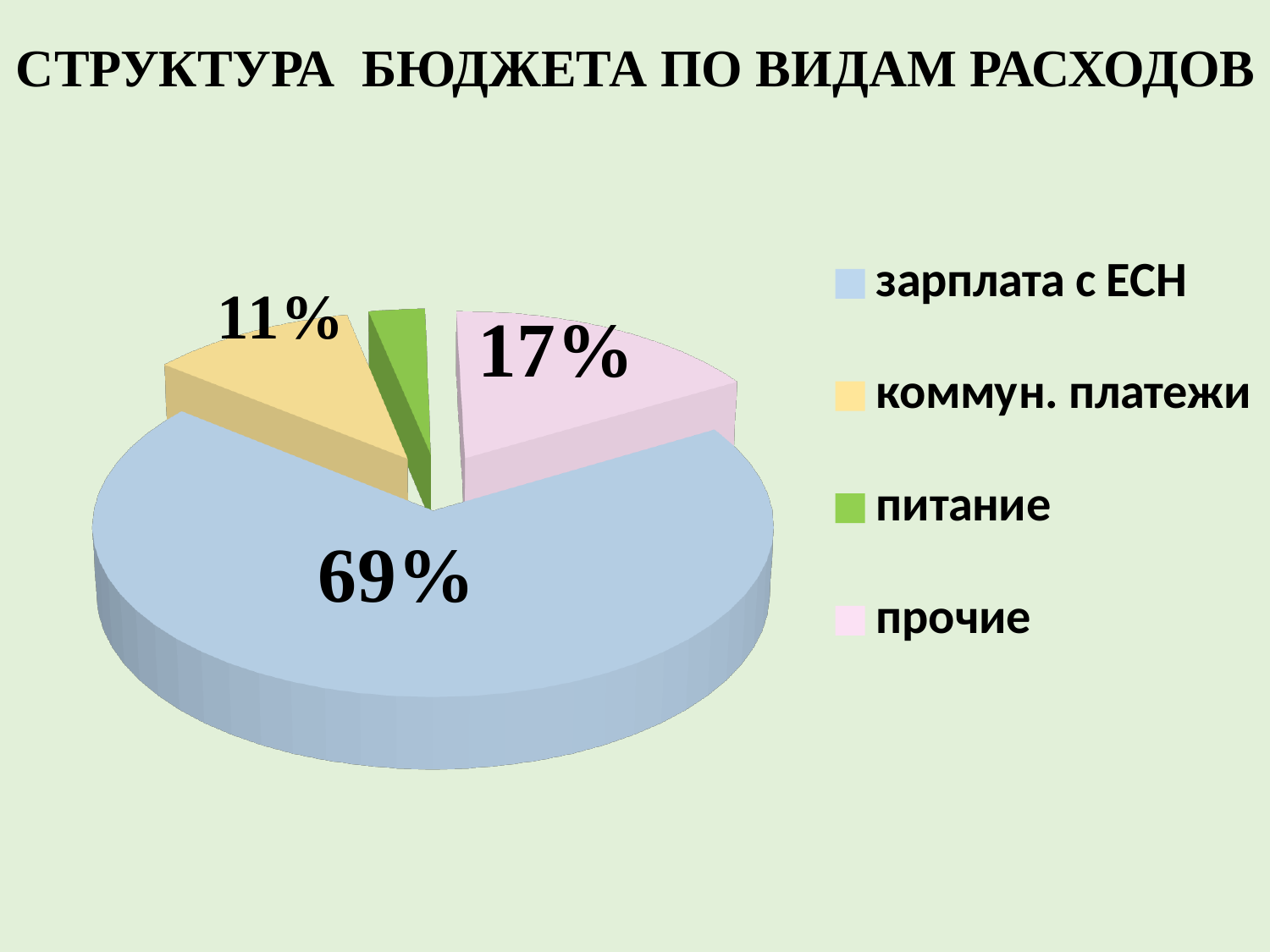
What kind of chart is shown on the slide? pie chart Which category has the smallest share of the pie? питание What is the title of the chart? СТРУКТУРА БЮДЖЕТА ПО ВИДАМ РАСХОДОВ By how many percentage points does прочие exceed коммун. платежи? 6 How many categories does the pie chart show? 4 How many entries does the legend list? 4 What share of the budget does прочие take? 17% What share of the budget does зарплата с ЕСН take? 69% Which is larger, the share for коммун. платежи or the share for прочие? прочие Which category has the largest share of the pie? зарплата с ЕСН What share of the budget does коммун. платежи take? 11% By how many percentage points does зарплата с ЕСН exceed прочие? 52